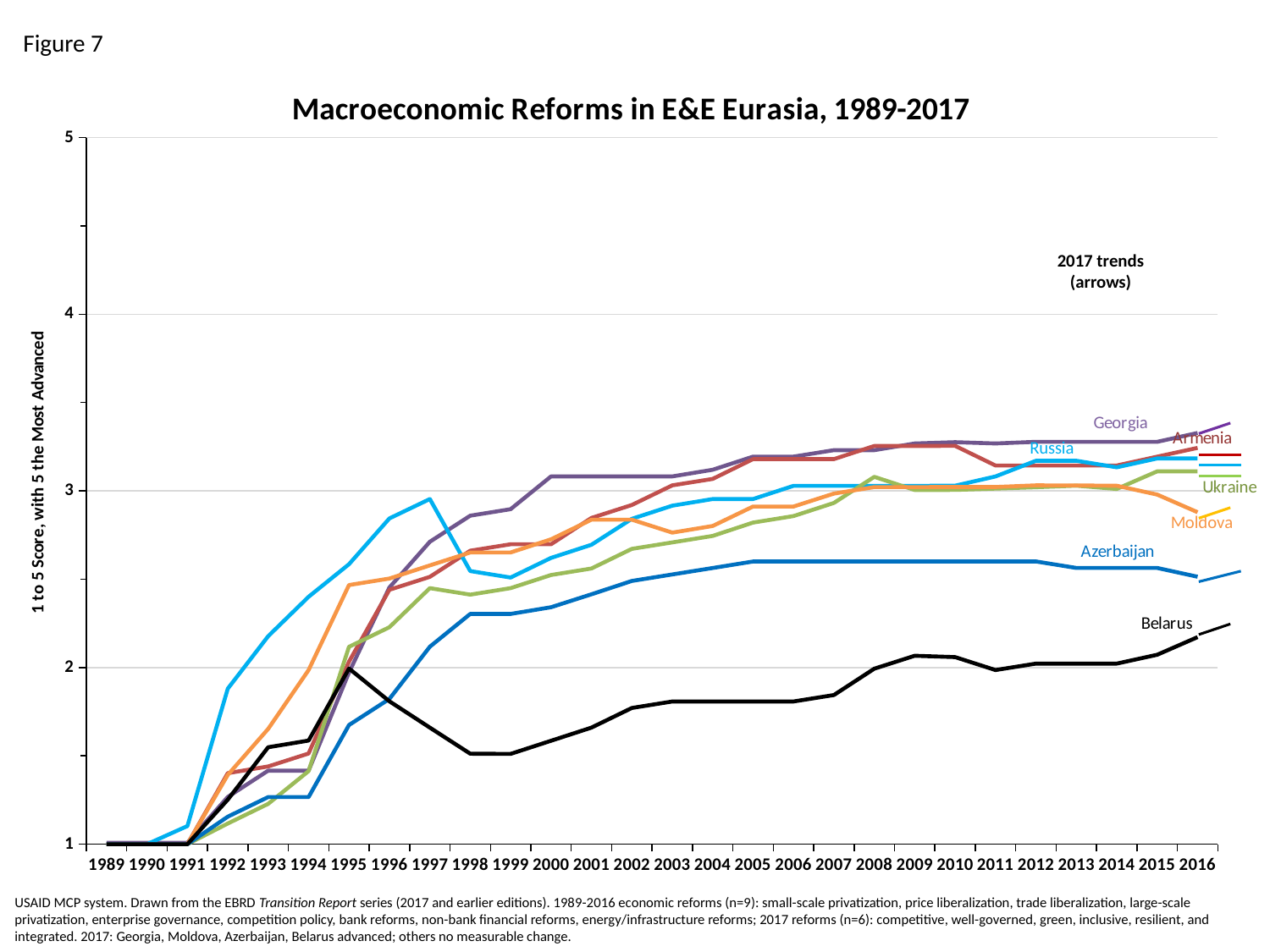
Is the value for Azerbaijan in 2016 greater or less than 3? less Which country has the highest score in 2016? Georgia What is the score for Belarus in 1989? 1 How many countries are plotted as lines on the chart? 7 Which has the higher score in 2016, Azerbaijan or Belarus? Azerbaijan What kind of chart is shown on the slide? line chart What is the label on the vertical axis? 1 to 5 Score, with 5 the Most Advanced Which country has the lowest score in 2016? Belarus What is the title of the chart? Macroeconomic Reforms in E&E Eurasia, 1989-2017 Does the Belarus line rise or fall between 1995 and 1998? fall Is the value for Georgia in 2016 greater or less than 3? greater Is the value for Belarus in 2016 greater or less than 3? less